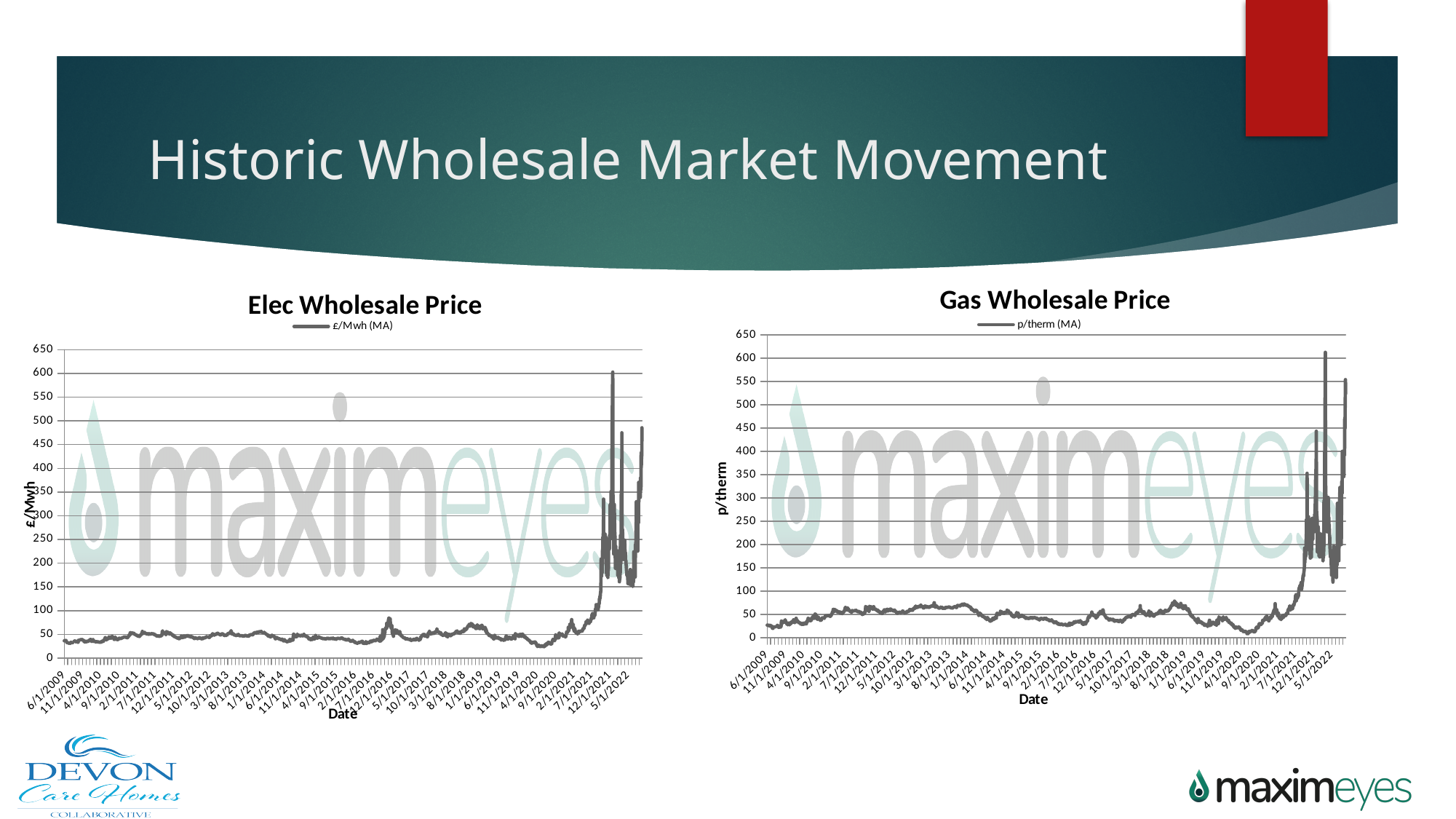
How many series does the legend of the Elec Wholesale Price chart list? 1 On the Gas Wholesale Price chart, is the value around 4/1/2020 greater or less than 50? less What is the legend entry on the Gas Wholesale Price chart? p/therm (MA) What kind of chart is the Elec Wholesale Price chart? line chart On the Gas Wholesale Price chart, is the highest peak in late 2021 greater or less than 550? greater On the Elec Wholesale Price chart, is the highest peak in late 2021 greater or less than 550? greater On the Elec Wholesale Price chart, do values overall rise or fall from 2020 to 2022? rise What kind of chart is the Gas Wholesale Price chart? line chart What is the y-axis title of the Elec Wholesale Price chart? £/Mwh